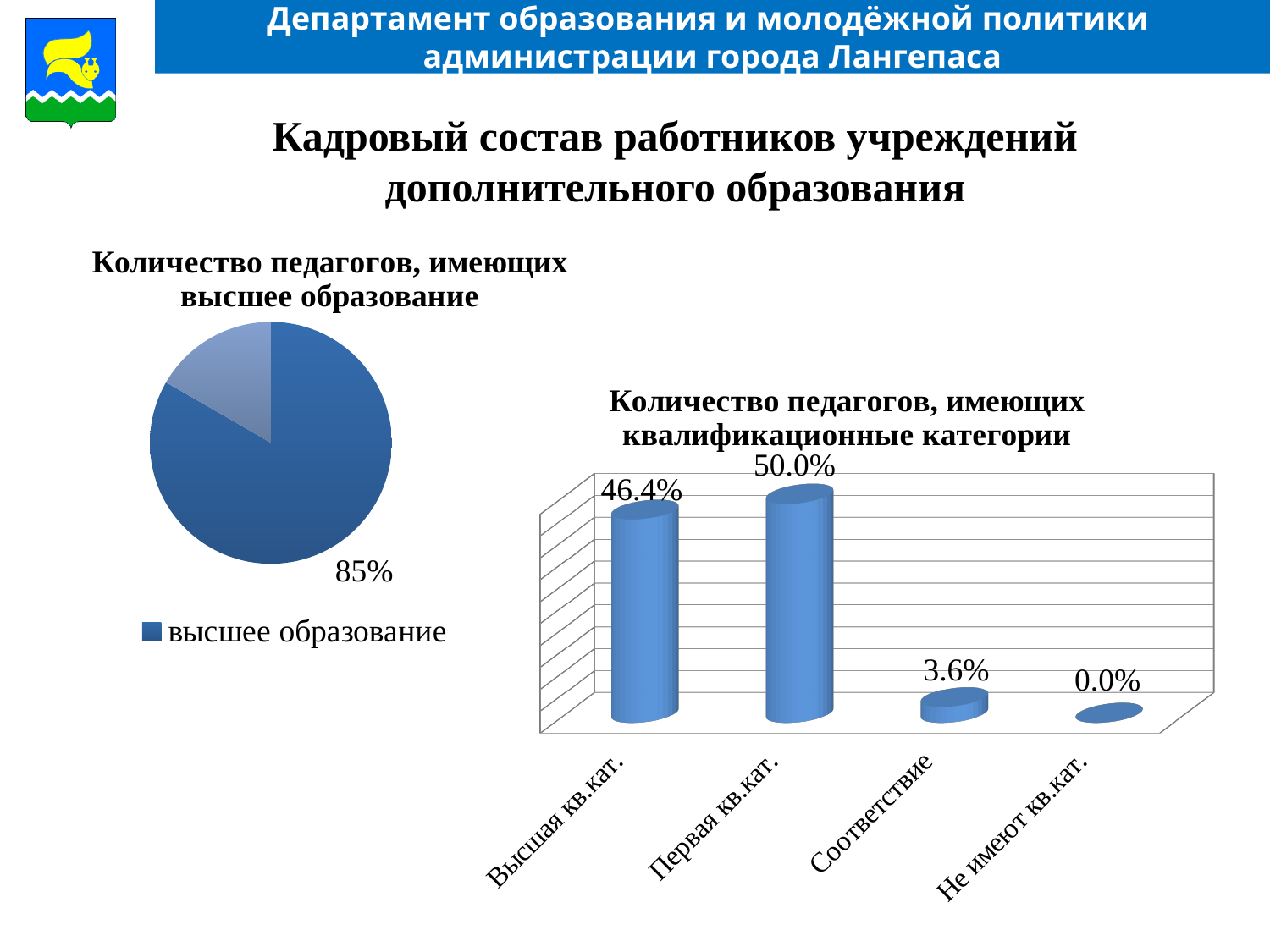
How many categories are shown in the chart titled "Количество педагогов, имеющих квалификационные категории"? 4 What kind of chart is the one titled "Количество педагогов, имеющих квалификационные категории"? Bar chart In the chart titled "Количество педагогов, имеющих квалификационные категории", which category has the lowest value? Не имеют кв.кат. What kind of chart is the one titled "Количество педагогов, имеющих высшее образование"? Pie chart In the chart titled "Количество педагогов, имеющих квалификационные категории", what is the value for "Соответствие"? 3.6% In the chart titled "Количество педагогов, имеющих квалификационные категории", what is the value for "Не имеют кв.кат."? 0.0% In the chart titled "Количество педагогов, имеющих квалификационные категории", what is the difference between the values for "Первая кв.кат." and "Высшая кв.кат."? 3.6% In the chart titled "Количество педагогов, имеющих квалификационные категории", what is the value for "Первая кв.кат."? 50.0% In the chart titled "Количество педагогов, имеющих квалификационные категории", what is the value for "Высшая кв.кат."? 46.4% In the pie chart titled "Количество педагогов, имеющих высшее образование", what share is labelled on the large slice? 85% In the chart titled "Количество педагогов, имеющих квалификационные категории", which category has the highest value? Первая кв.кат. In the chart titled "Количество педагогов, имеющих квалификационные категории", which is larger: the value for "Высшая кв.кат." or the value for "Соответствие"? Высшая кв.кат.